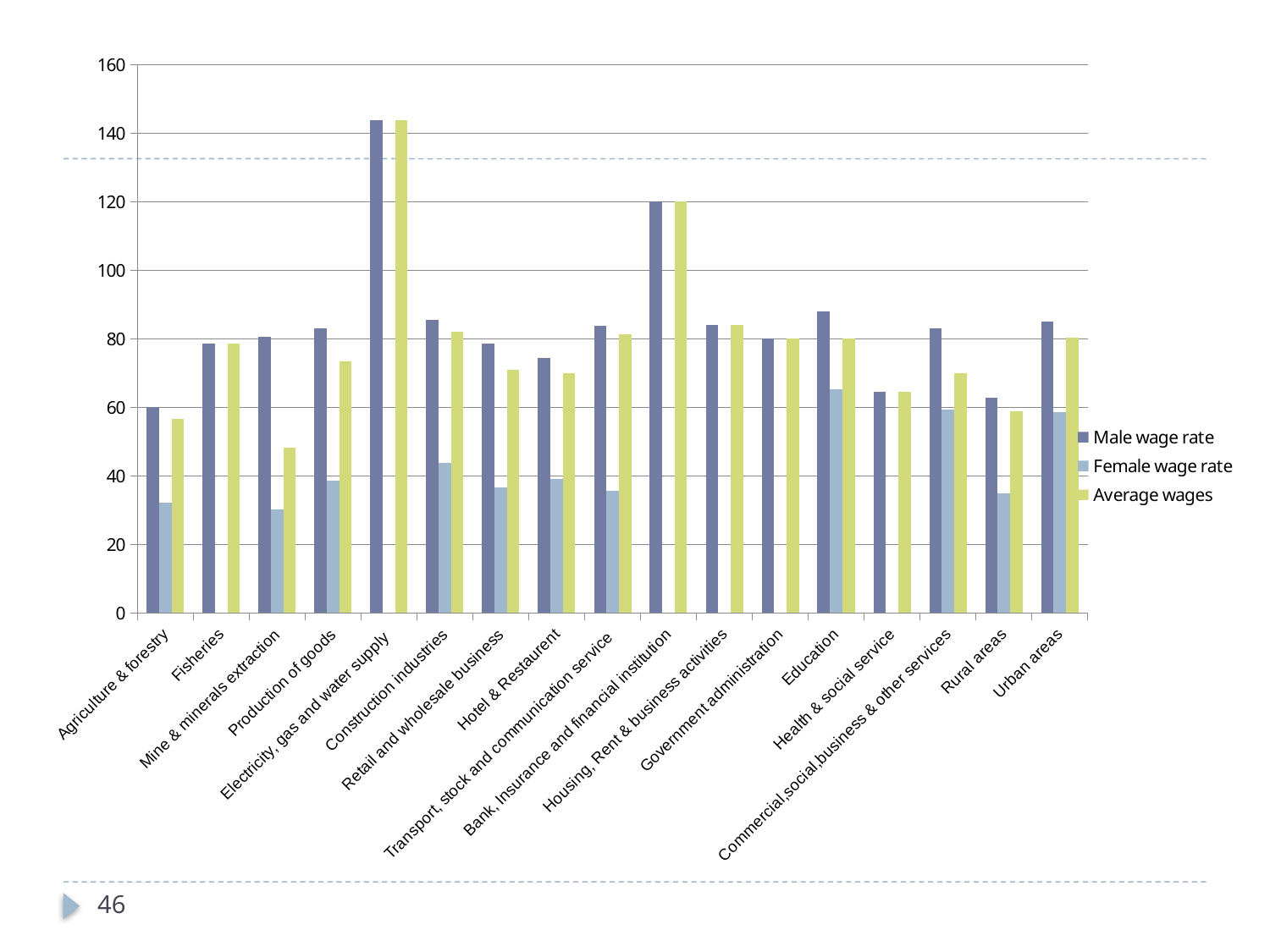
Is the Average wages value for Mine & minerals extraction greater or less than 60? less Which category has the highest Female wage rate? Education Is the Female wage rate for Agriculture & forestry greater or less than 40? less Is the Male wage rate for Electricity, gas and water supply greater or less than 140? greater What kind of chart is shown on the slide? bar chart How many series does the legend list? 3 Which category has the highest Average wages? Electricity, gas and water supply How many categories are shown on the x axis? 17 Which is larger, the Male wage rate for Education or the Male wage rate for Health & social service? Education Which category has the highest Male wage rate? Electricity, gas and water supply What is the Male wage rate for Bank, Insurance and financial institution? 120